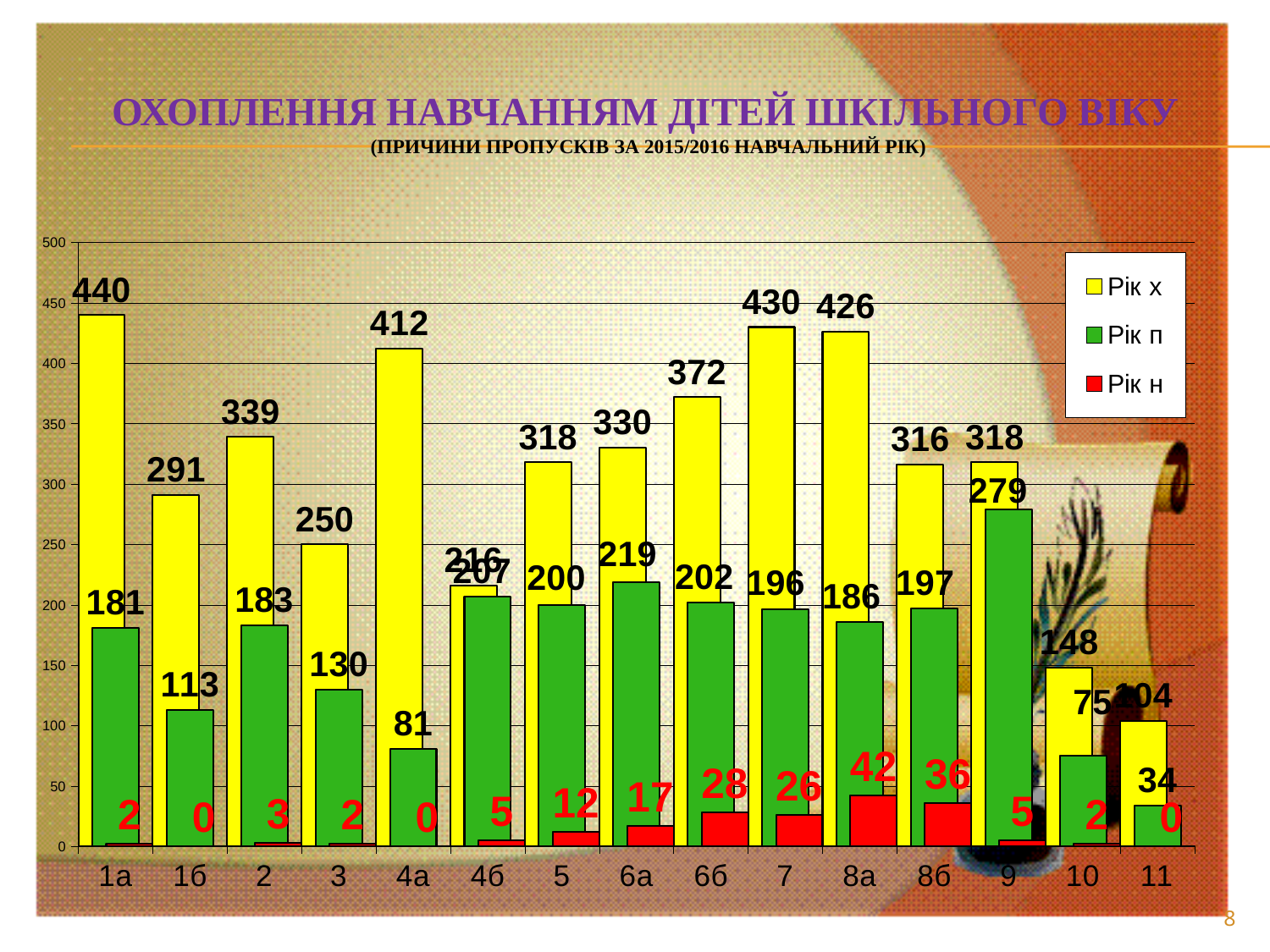
What is the value of Рік п for category 9? 279 Which category has the highest value for Рік н? 8а Which category has the highest value for Рік х? 1а What colour represents the series Рік н in the legend? red What is the difference between Рік х and Рік п for category 7? 234 Which category has the lowest value for Рік п? 11 Which category has the larger Рік х value, 2 or 3? 2 What kind of chart is shown on the slide? bar chart How many categories are shown along the x axis? 15 What is the value of Рік н for category 8а? 42 What is the value of Рік х for category 1а? 440 How many series does the legend list? 3